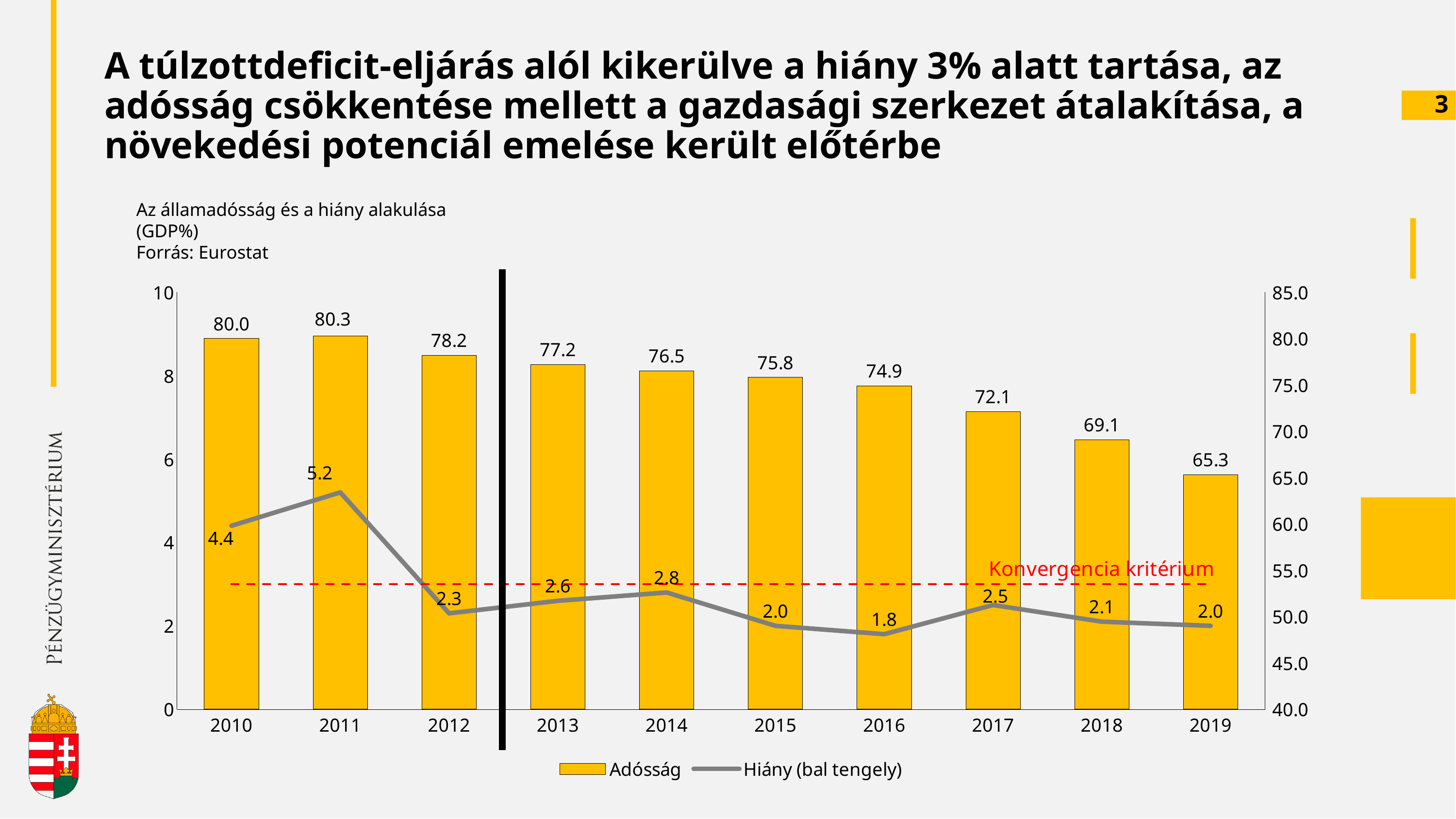
In which year is the Adósság value highest? 2011 Do the Adósság values rise or fall from 2013 to 2019? Fall How many years are shown on the x axis? 10 What is the Adósság value for 2011? 80.3 What is the source cited for the chart? Eurostat What is the Hiány value for 2016? 1.8 What kind of chart is shown on the slide? Combined bar and line chart In which year is the Hiány value lowest? 2016 What is the difference between the Adósság values for 2010 and 2019? 14.7 Which year has the larger Hiány value, 2011 or 2014? 2011 What is the Adósság value for 2019? 65.3 How many series does the legend list? 2